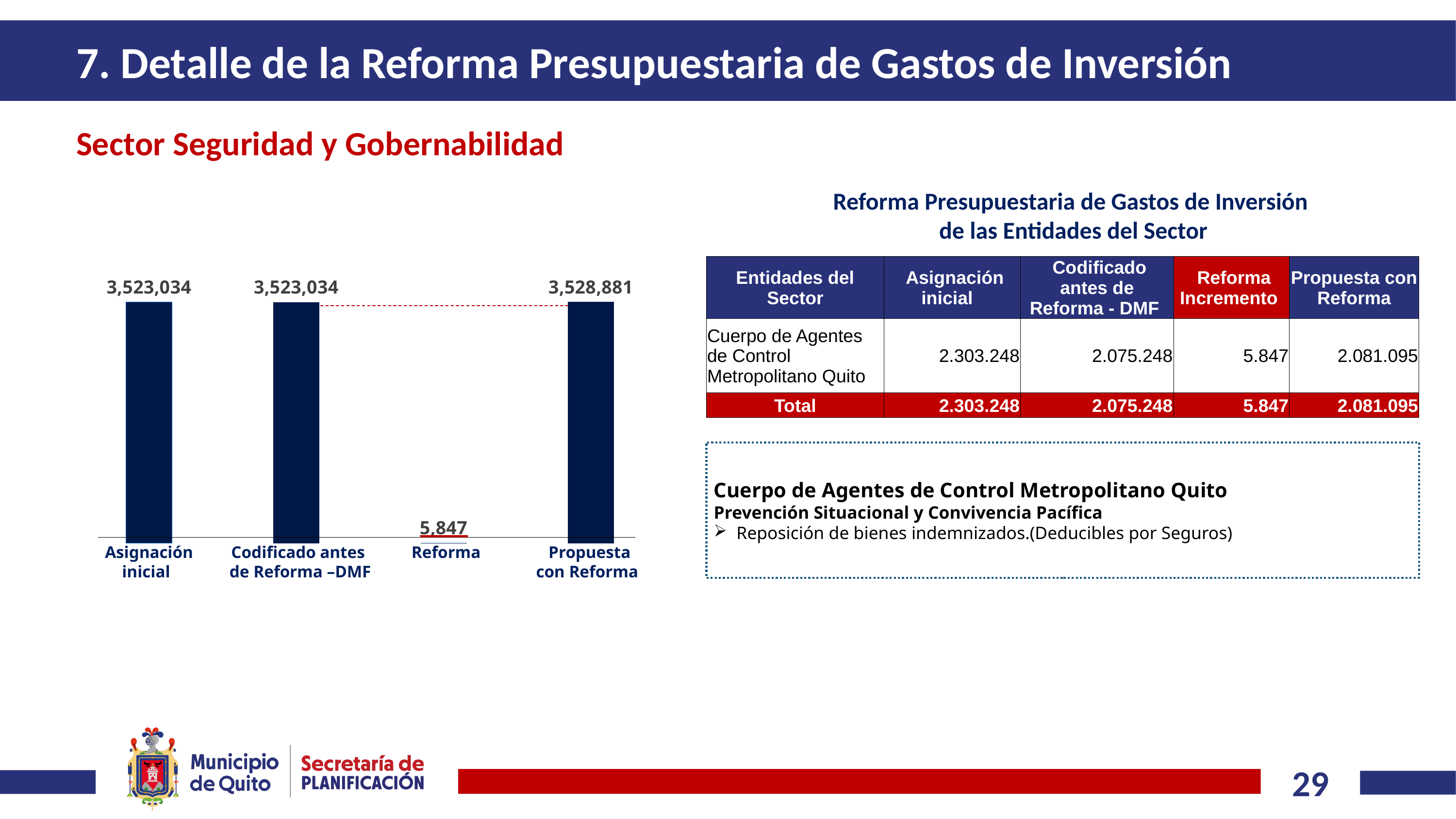
What kind of chart is shown on the slide? Bar chart How many categories are shown on the x axis of the chart? 4 What is the difference between the values for Propuesta con Reforma and Codificado antes de Reforma –DMF? 5,847 What value does the chart show for Propuesta con Reforma? 3,528,881 What value does the chart show for Asignación inicial? 3,523,034 Do the values for Asignación inicial and Codificado antes de Reforma –DMF differ? No, both are 3,523,034 What value does the chart show for Codificado antes de Reforma –DMF? 3,523,034 Which category in the chart has the lowest value? Reforma What value does the chart show for Reforma? 5,847 Which category in the chart has the highest value? Propuesta con Reforma Which is larger in the chart, the value for Propuesta con Reforma or the value for Asignación inicial? Propuesta con Reforma What colour are the bars for Asignación inicial, Codificado antes de Reforma –DMF and Propuesta con Reforma? Dark navy blue